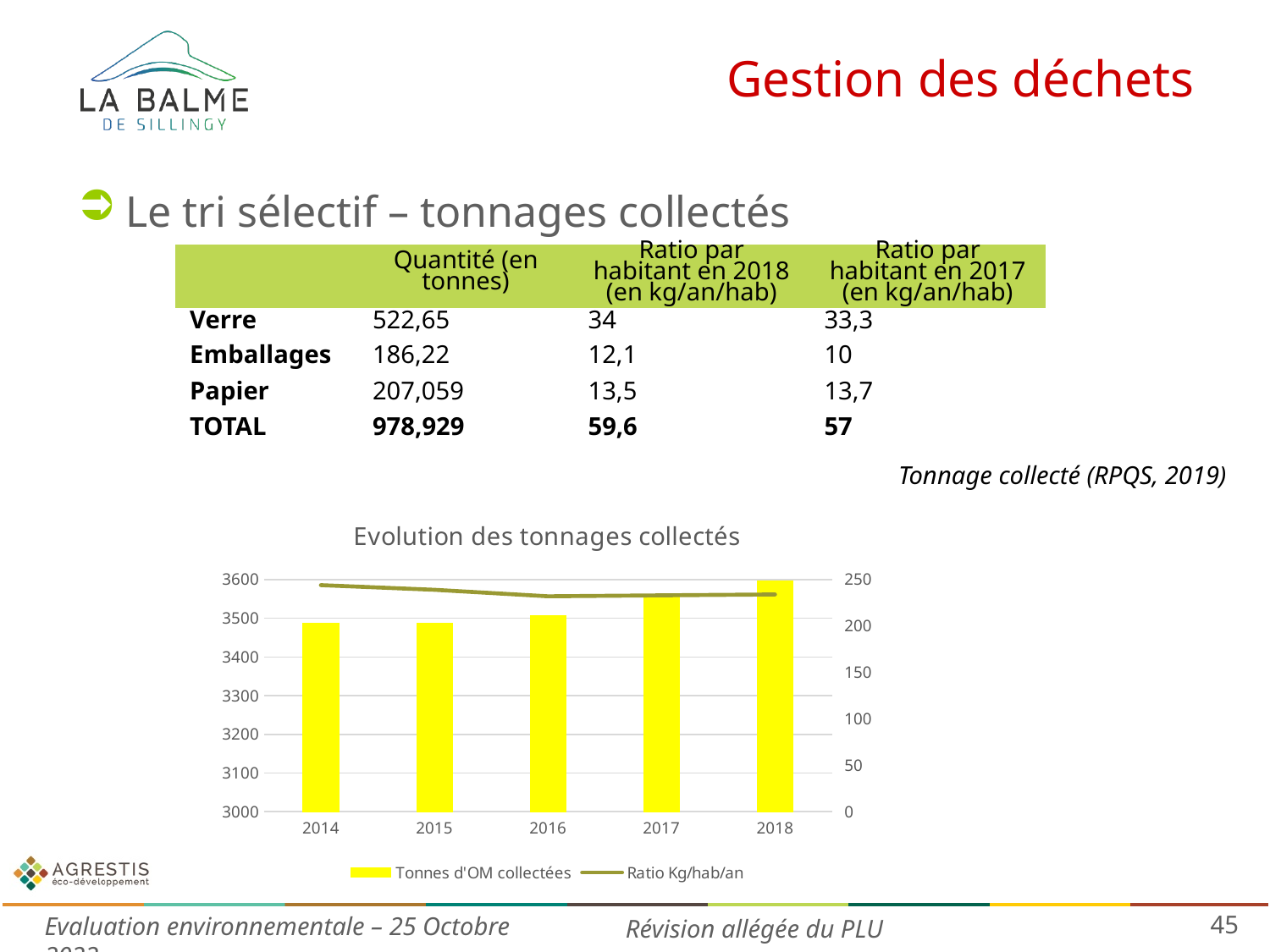
In the "Evolution des tonnages collectés" chart, is the bar for Tonnes d'OM collectées in 2018 greater or less than 3500? greater What kind of chart is "Evolution des tonnages collectés"? A bar chart with a line series In the "Evolution des tonnages collectés" chart, is the bar for Tonnes d'OM collectées in 2014 greater or less than 3400? greater In the "Evolution des tonnages collectés" chart, does the Ratio Kg/hab/an line rise or fall from 2014 to 2016? fall What colour are the bars in the "Evolution des tonnages collectés" chart? Yellow How many years are shown on the x axis of the "Evolution des tonnages collectés" chart? 5 In the "Evolution des tonnages collectés" chart, which year has the highest bar for Tonnes d'OM collectées? 2018 In the "Evolution des tonnages collectés" chart, which bar is taller: 2014 or 2018? 2018 How many series does the legend of the "Evolution des tonnages collectés" chart list? 2 In the "Evolution des tonnages collectés" chart, is the bar for Tonnes d'OM collectées in 2017 greater or less than 3500? greater In the "Evolution des tonnages collectés" chart, do the bars for Tonnes d'OM collectées generally rise or fall from 2014 to 2018? rise